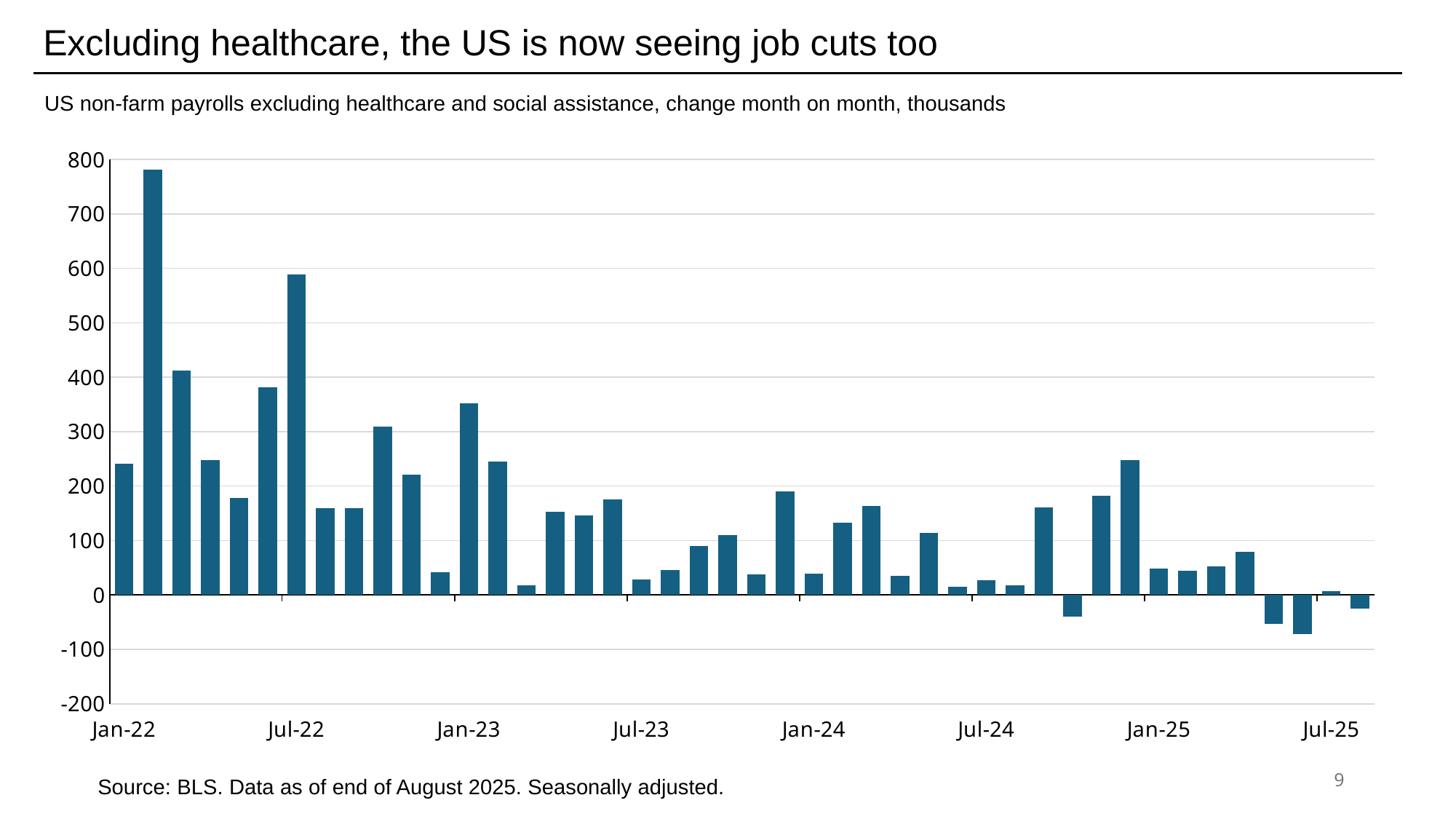
Do the monthly values generally rise or fall from Jan-22 to Jul-25? fall What is the title of the slide? Excluding healthcare, the US is now seeing job cuts too Which is larger, the value for Jul-22 or the value for Jan-23? Jul-22 Is the value for Jan-25 greater or less than 100? less Is the value for Jan-22 greater or less than 200? greater How many bars on the chart show a negative value? 4 Which is larger, the value for Jan-22 or the value for Jan-23? Jan-23 Is the value for Jan-23 greater or less than 300? greater What kind of chart is shown on the slide? Bar chart